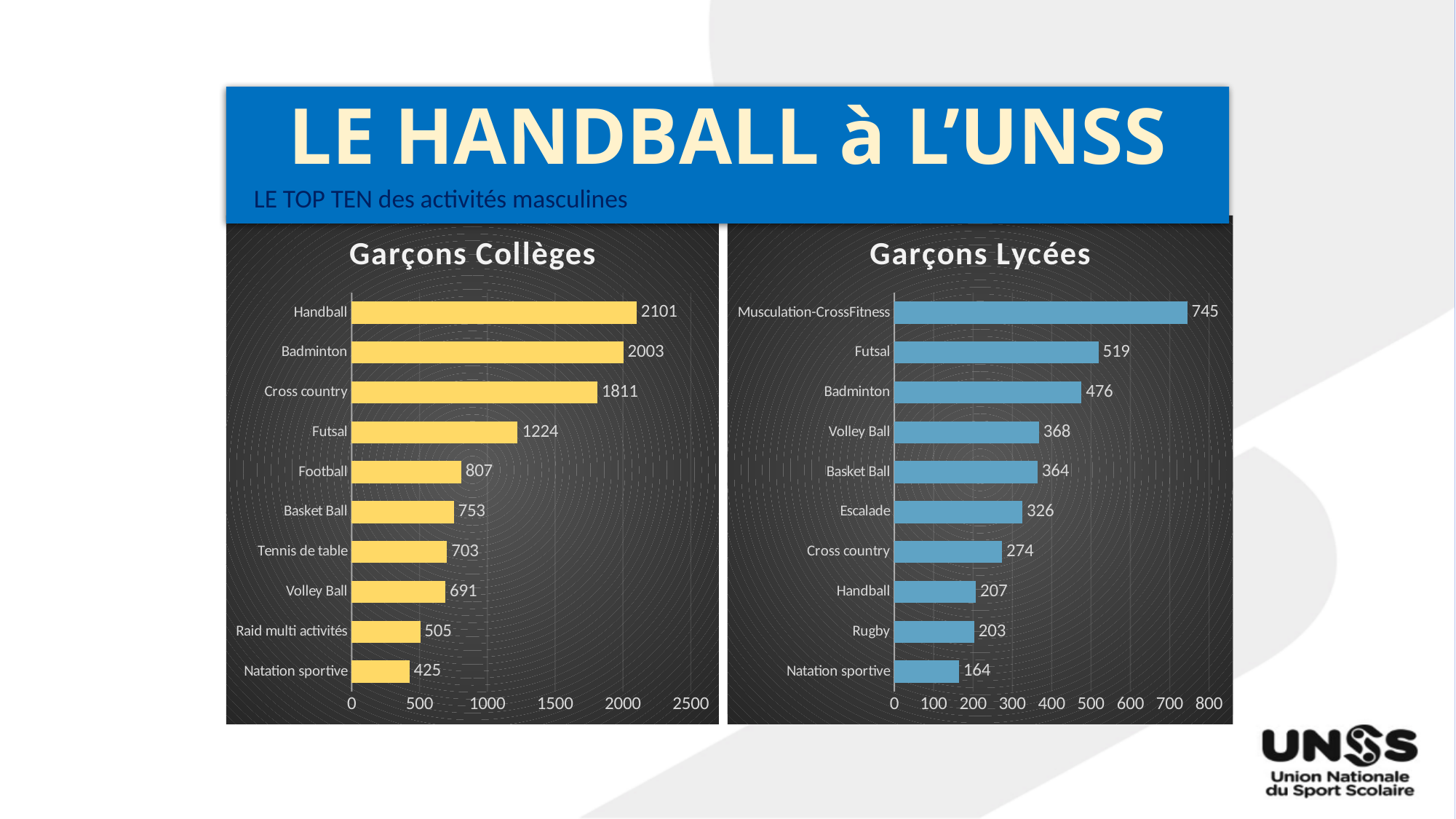
What is the title of the chart on the left of the slide? Garçons Collèges How many activities are shown in the 'Garçons Collèges' chart? 10 In the 'Garçons Lycées' chart, what is the value for Handball? 207 What kind of chart is the 'Garçons Lycées' chart? Bar chart In the 'Garçons Collèges' chart, what is the value for Handball? 2101 In the 'Garçons Collèges' chart, which activity has the lowest value? Natation sportive In the 'Garçons Lycées' chart, is the value for Escalade greater or less than 300? greater In the 'Garçons Lycées' chart, what is the value for Futsal? 519 In the 'Garçons Collèges' chart, what is the difference between Handball and Badminton? 98 In the 'Garçons Collèges' chart, which is larger: Football or Futsal? Futsal In the 'Garçons Lycées' chart, which activity has the highest value? Musculation-CrossFitness In the 'Garçons Lycées' chart, what is the difference between Musculation-CrossFitness and Natation sportive? 581